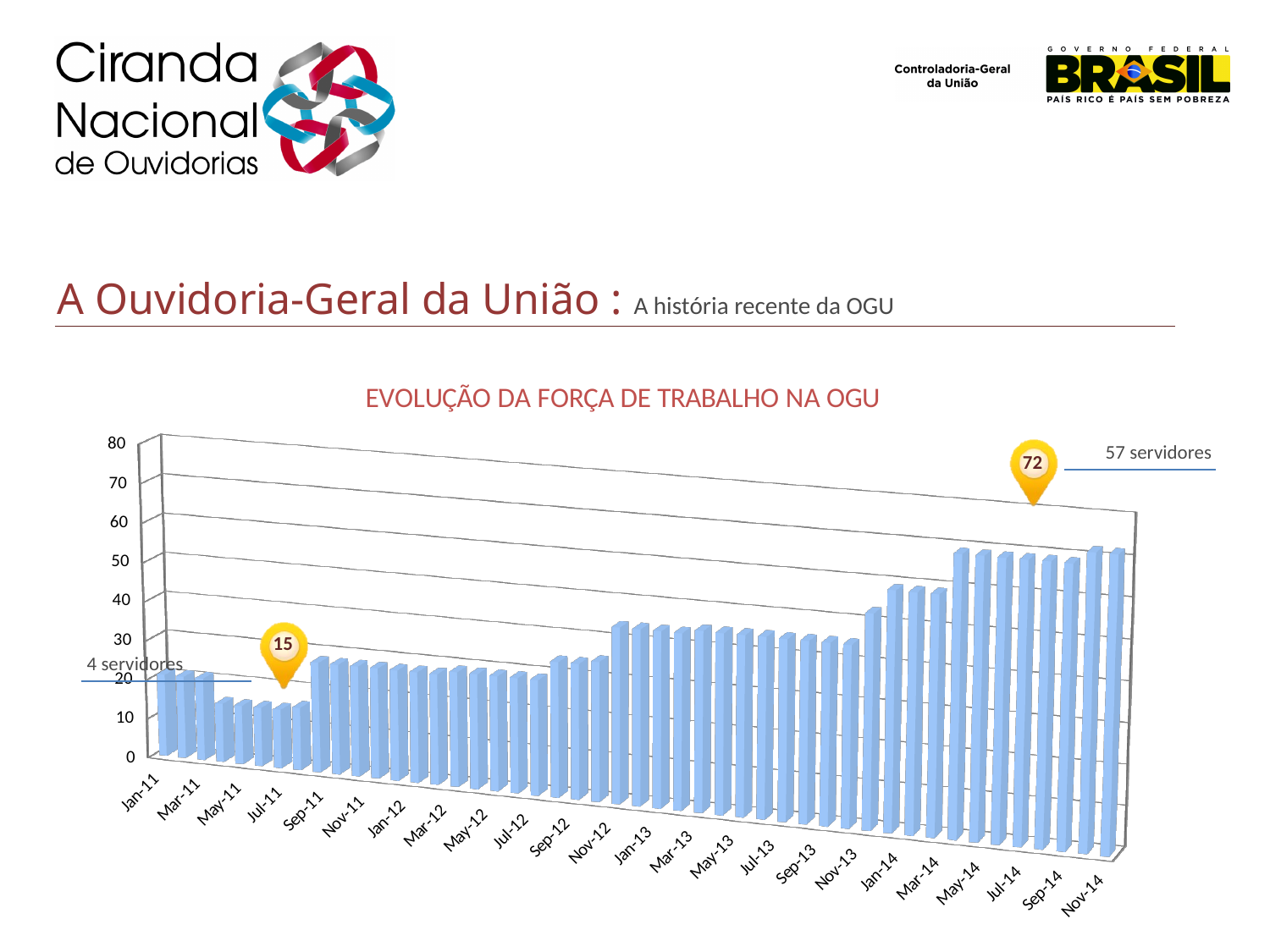
What is the title of the chart? EVOLUÇÃO DA FORÇA DE TRABALHO NA OGU Is the value for Sep-12 greater or less than 40? less What kind of chart is shown on the slide? bar chart Is the value for Jan-14 greater or less than 30? greater Which is larger, the value for Mar-11 or the value for Jul-11? Mar-11 Which is larger, the value for Jan-13 or the value for Jan-12? Jan-13 Overall, do the values rise or fall from Jan-11 to Nov-14? rise Is the value for Jan-11 greater or less than 40? less Which is larger, the value for Jan-14 or the value for Jan-13? Jan-14 What number is shown in the marker near the right end of the chart? 72